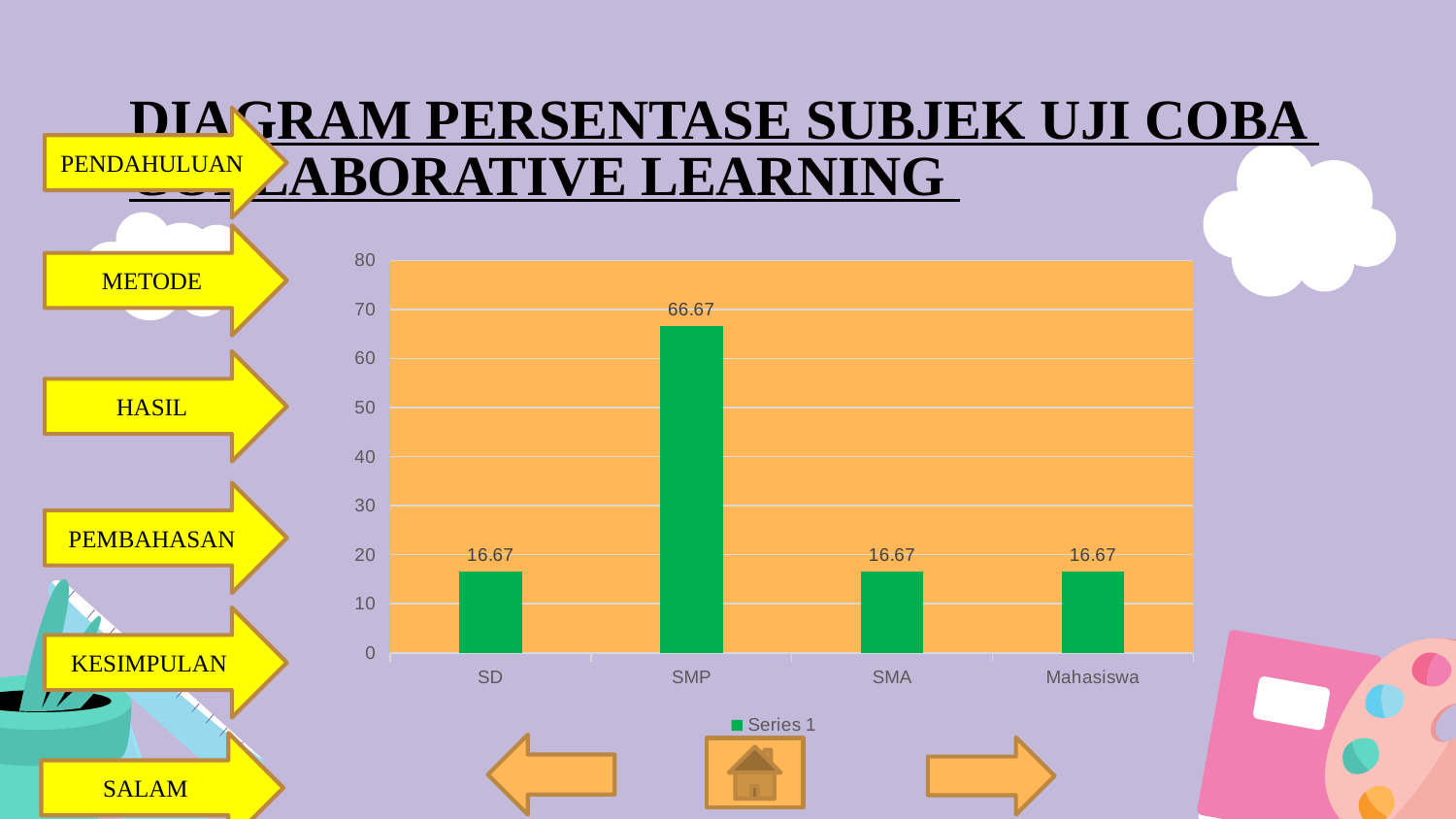
Is the value for SMP greater or less than 60? greater What is the difference between the values for SMP and SMA? 50 Which is larger, the value for SMP or the value for SD? SMP Which category has the highest value? SMP Is the value for SMA greater or less than 20? less What is the name of the series shown in the legend? Series 1 What kind of chart is shown on the slide? bar chart What is the value for SMP? 66.67 What is the value for Mahasiswa? 16.67 What is the value for SD? 16.67 How many series does the legend list? 1 How many categories are shown on the x axis? 4